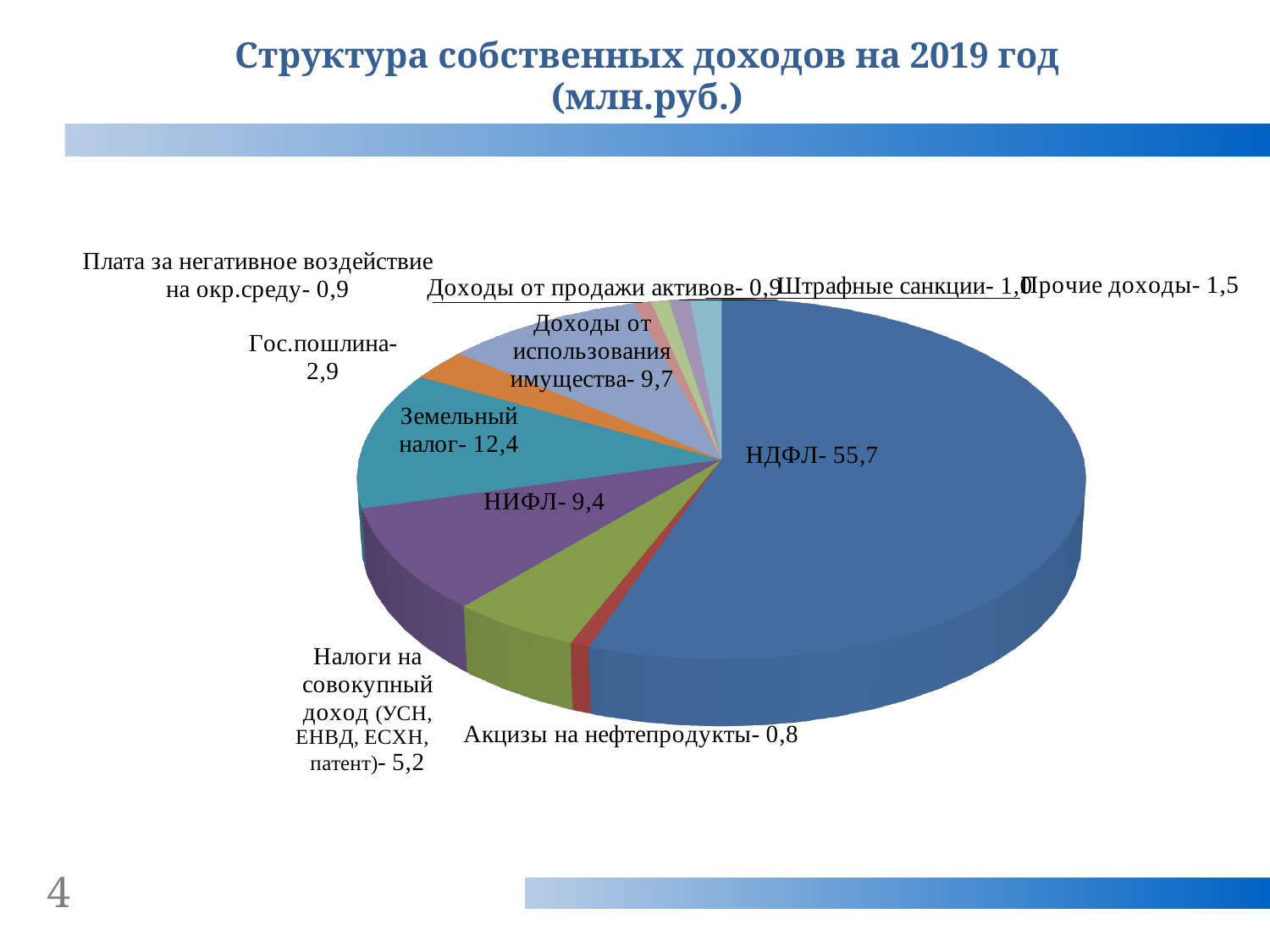
What is the value for НДФЛ? 55,7 What type of chart is shown on the slide? Pie chart Which category has the smallest value in the pie chart? Акцизы на нефтепродукты What is the title of the chart on the slide? Структура собственных доходов на 2019 год (млн.руб.) Which category has the largest slice of the pie? НДФЛ Which is larger: Земельный налог or Доходы от использования имущества? Земельный налог What is the difference between the values for Земельный налог and НИФЛ? 3,0 What is the value for Налоги на совокупный доход (УСН, ЕНВД, ЕСХН, патент)? 5,2 How many slices does the pie chart have? 11 What is the value for Гос.пошлина? 2,9 What is the value for Земельный налог? 12,4 What is the value for Доходы от использования имущества? 9,7